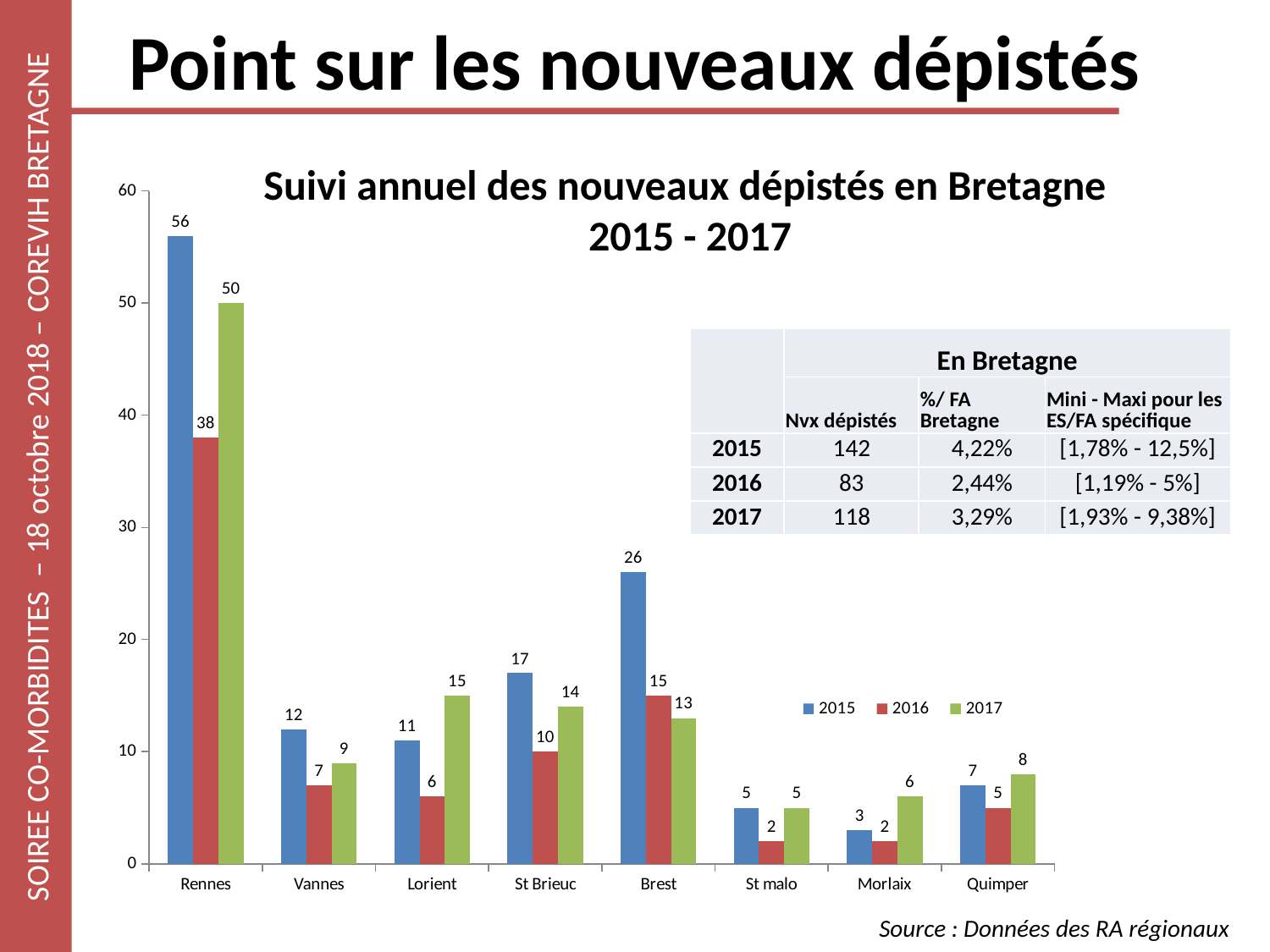
How many series does the legend list? 3 What is the title of the chart? Suivi annuel des nouveaux dépistés en Bretagne 2015 - 2017 What is the difference between the 2015 and 2016 values for Rennes? 18 What is the value for Rennes in 2015? 56 Which is larger: the 2015 value for St Brieuc or the 2015 value for Brest? Brest How many cities are shown on the x axis? 8 Which city has the lowest value in 2015? Morlaix Which city has the highest value in 2017? Rennes What is the value for Lorient in 2017? 15 What kind of chart is shown? bar chart What is the value for Brest in 2016? 15 Is the value for Rennes in 2017 greater or less than 40? greater